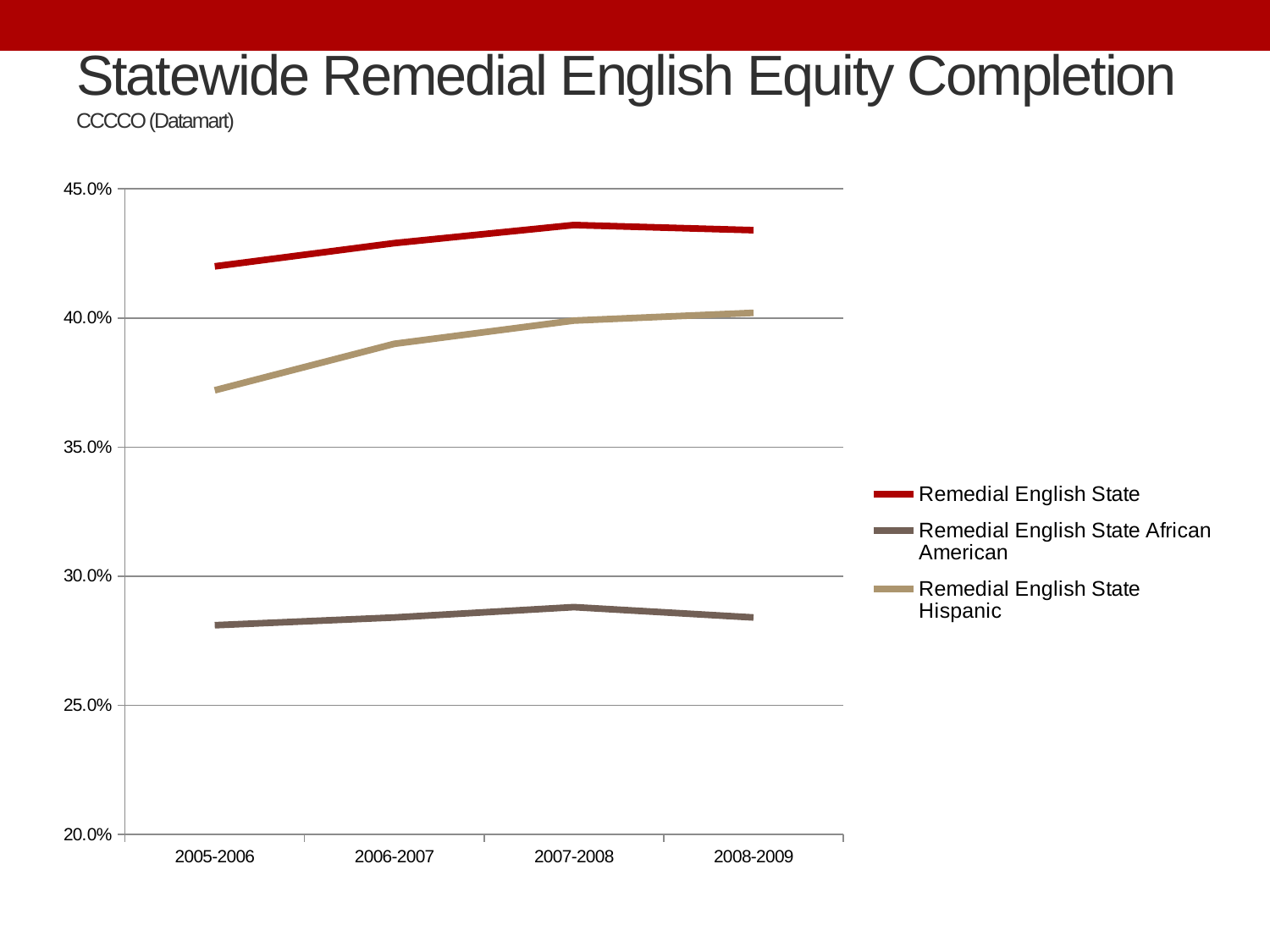
Which series has the highest value in 2008-2009? Remedial English State What is the title of the chart on the slide? Statewide Remedial English Equity Completion Which series has the lowest value in 2005-2006? Remedial English State African American How many series does the legend list? 3 Which is larger in 2006-2007: Remedial English State Hispanic or Remedial English State African American? Remedial English State Hispanic Is the value for Remedial English State African American in 2007-2008 greater or less than 30.0%? less Is the value for Remedial English State Hispanic in 2005-2006 greater or less than 40.0%? less How many academic years are shown on the x axis? 4 What kind of chart is shown on the slide? line chart In which year is the Remedial English State Hispanic value lowest? 2005-2006 Does the Remedial English State Hispanic line rise or fall from 2005-2006 to 2008-2009? rise Is the value for Remedial English State in 2005-2006 greater or less than 40.0%? greater